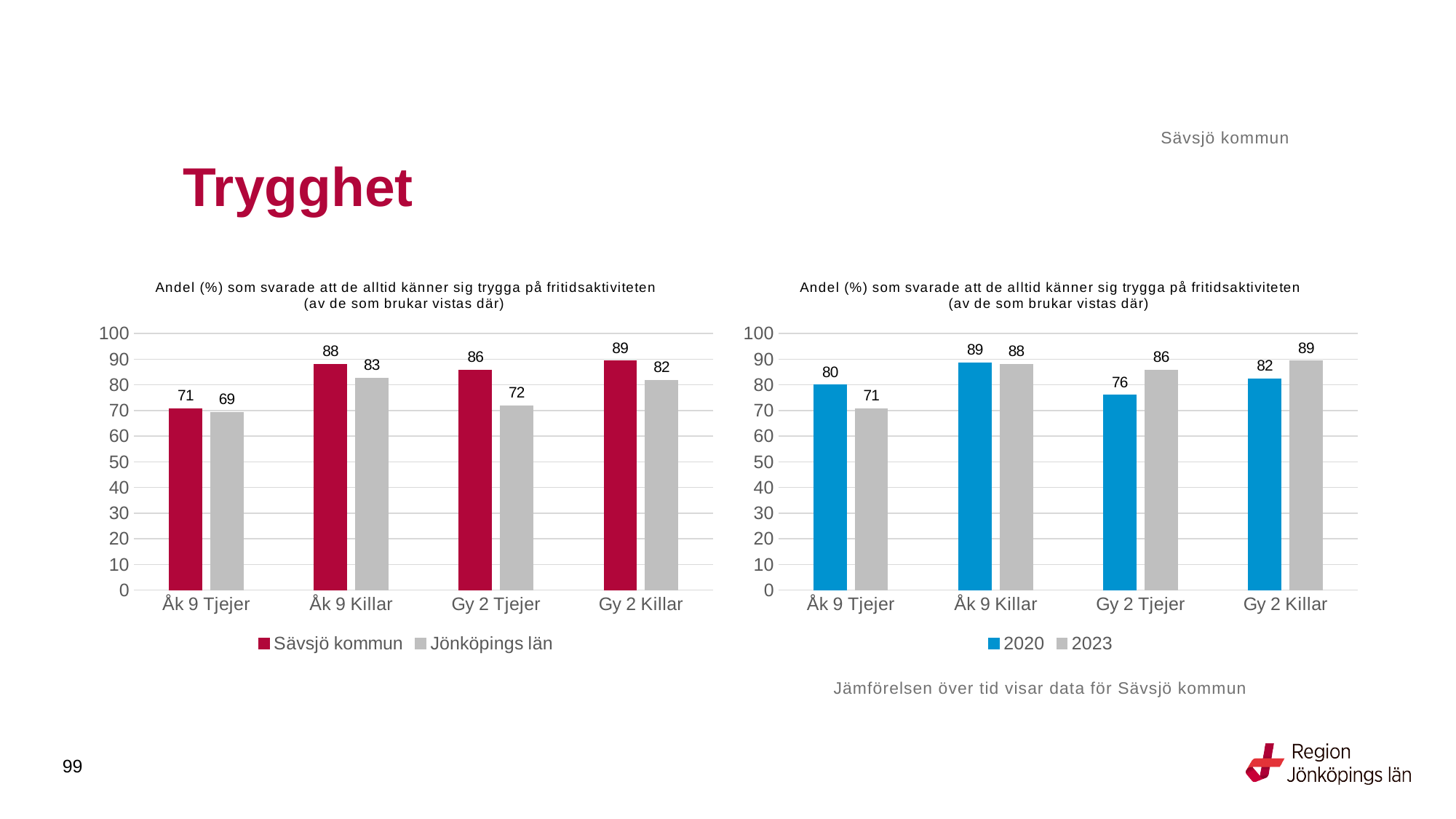
In the left chart, what is the value for Sävsjö kommun for Gy 2 Tjejer? 86 How many categories are shown on the x axis of the left chart? 4 In the left chart, what is the difference between Sävsjö kommun and Jönköpings län for Gy 2 Tjejer? 14 In the right chart, what is the value for 2020 for Gy 2 Tjejer? 76 In the right chart, which category has the lowest value for 2020? Gy 2 Tjejer In the left chart, which category has the lowest value for Jönköpings län? Åk 9 Tjejer In the left chart, what is the value for Jönköpings län for Åk 9 Killar? 83 What type of chart is the right chart? Bar chart In the left chart, which category has the highest value for Sävsjö kommun? Gy 2 Killar In the right chart, what is the value for 2023 for Åk 9 Tjejer? 71 In the right chart, which is larger for Gy 2 Killar, 2020 or 2023? 2023 In the right chart, what is the difference between 2020 and 2023 for Åk 9 Tjejer? 9